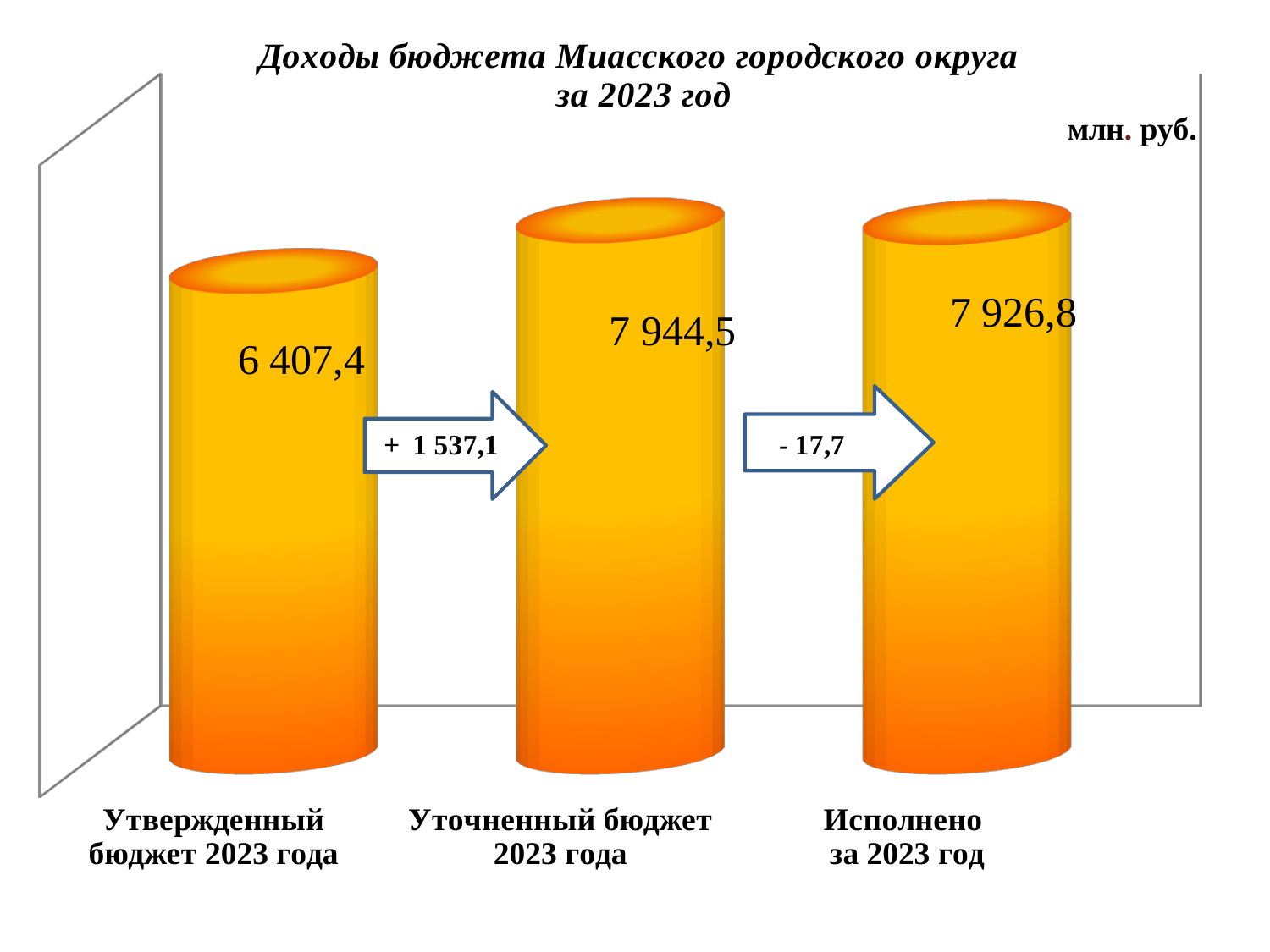
Which category has the highest value? Уточненный бюджет 2023 года How many categories are shown in the chart? 3 What is the value for Уточненный бюджет 2023 года? 7 944,5 What kind of chart is shown on the slide? Bar chart In what units are the values on the chart given? млн. руб. Which category has the lowest value? Утвержденный бюджет 2023 года What is the title of the chart? Доходы бюджета Миасского городского округа за 2023 год Which is larger: Утвержденный бюджет 2023 года or Исполнено за 2023 год? Исполнено за 2023 год What is the difference between Уточненный бюджет 2023 года and Исполнено за 2023 год? 17,7 What is the difference between Уточненный бюджет 2023 года and Утвержденный бюджет 2023 года? 1 537,1 What is the value for Исполнено за 2023 год? 7 926,8 What is the value for Утвержденный бюджет 2023 года? 6 407,4